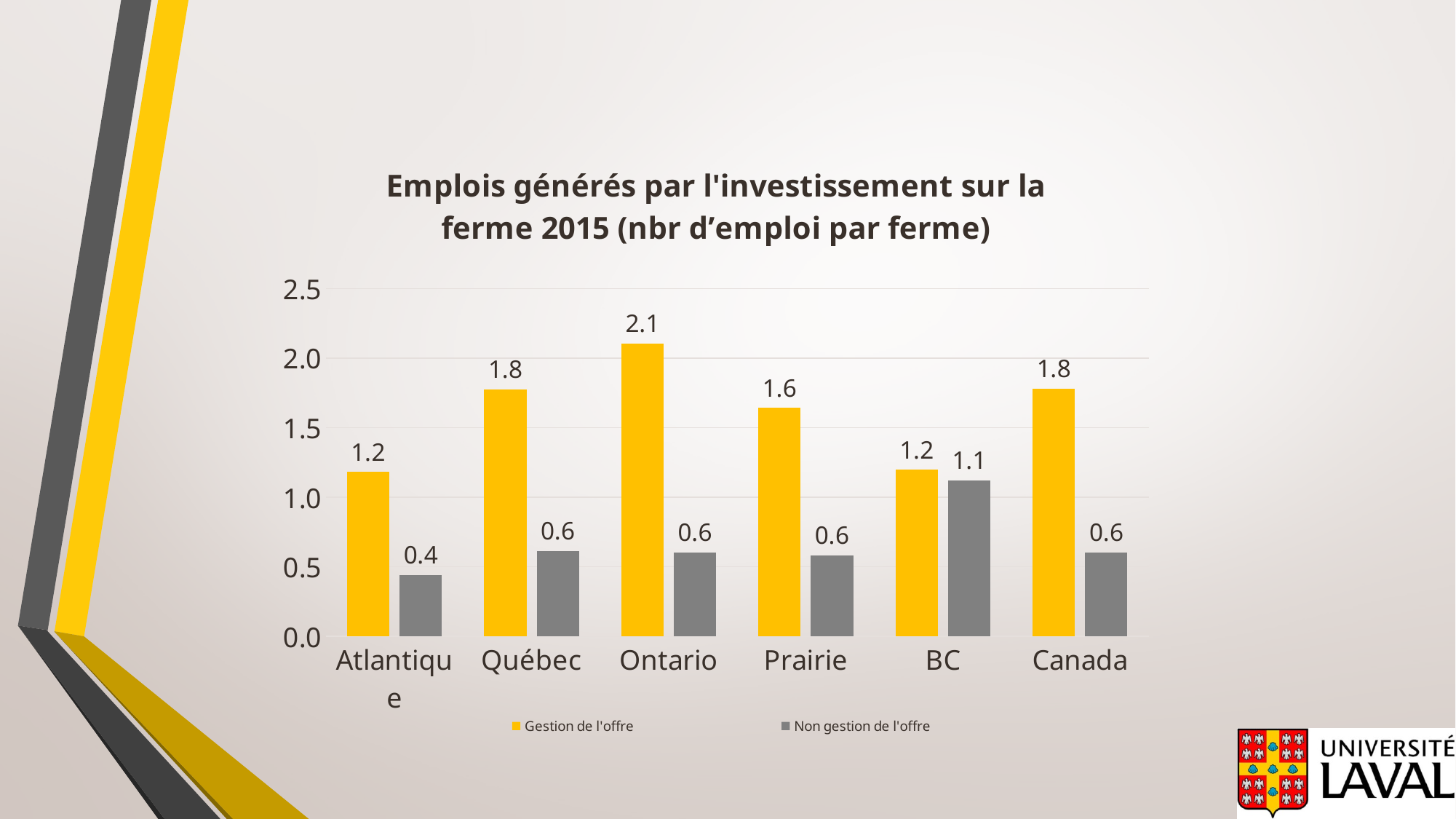
Which region has the highest value for Gestion de l'offre? Ontario Which region has the lowest value for Non gestion de l'offre? Atlantique What is the value for Non gestion de l'offre in BC? 1.1 What is the value for Gestion de l'offre in Ontario? 2.1 What is the difference between Gestion de l'offre and Non gestion de l'offre in Québec? 1.2 Which is larger in Prairie: Gestion de l'offre or Non gestion de l'offre? Gestion de l'offre Is the value for Gestion de l'offre in Canada greater or less than 1.5? greater What kind of chart is shown on the slide? Bar chart What is the value for Non gestion de l'offre in Atlantique? 0.4 How many regions are shown on the x axis? 6 What colour are the bars for Gestion de l'offre? Yellow How many series does the legend list? 2